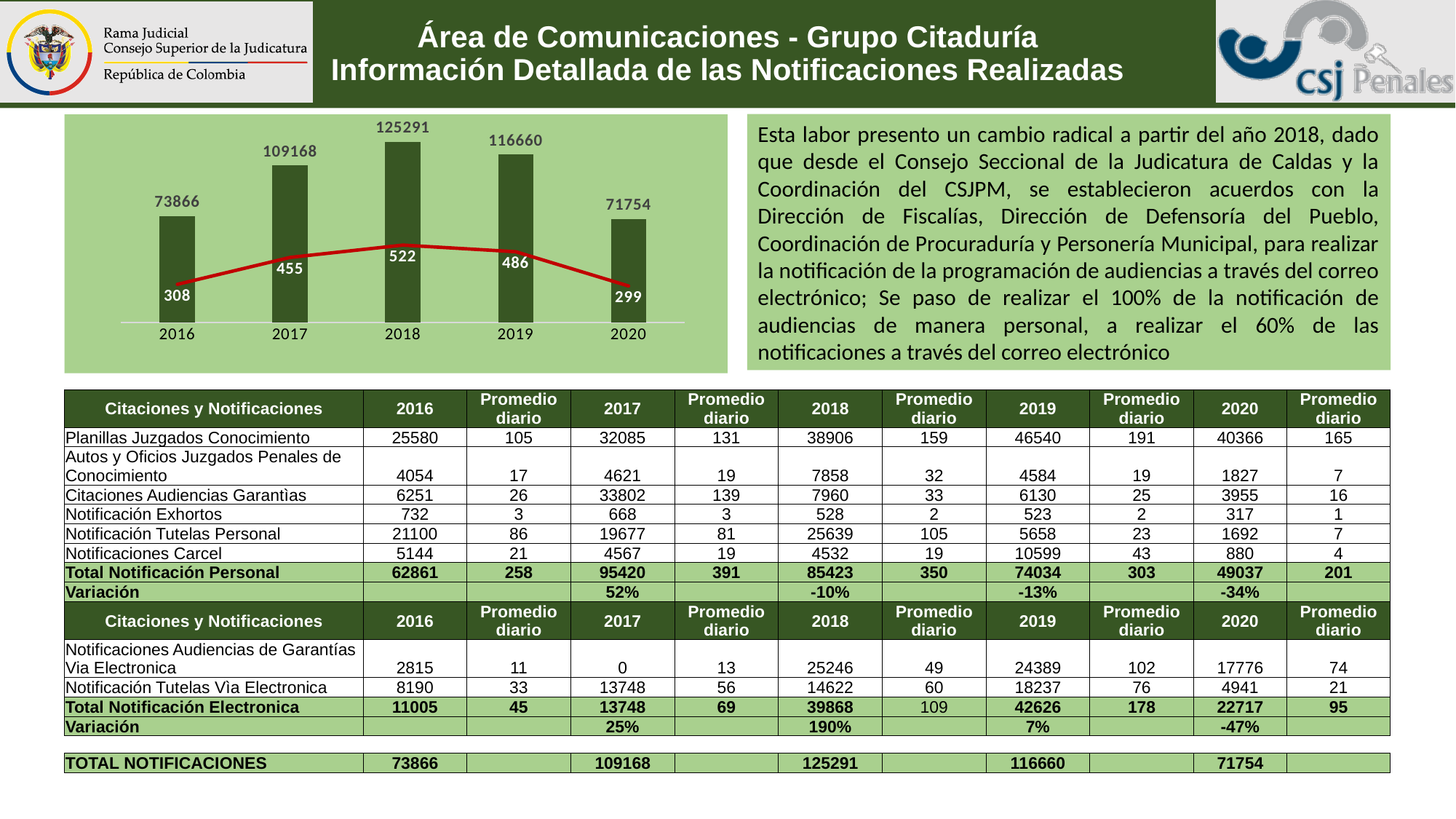
What is the difference between the line values for 2018 and 2020 in the chart? 223 Do the bar values rise or fall from 2018 to 2020 in the chart? Fall Which year has the larger bar value in the chart, 2017 or 2019? 2019 What is the line value shown for 2016 in the chart? 308 Which year has the highest bar in the chart? 2018 What kind of chart is shown on the slide? Combined bar and line chart What is the line value shown for 2017 in the chart? 455 What is the difference between the bar values for 2018 and 2019 in the chart? 8631 What is the bar value for 2018 in the chart? 125291 Which year has the lowest bar in the chart? 2020 What is the bar value for 2020 in the chart? 71754 How many years are shown on the x axis of the chart? 5